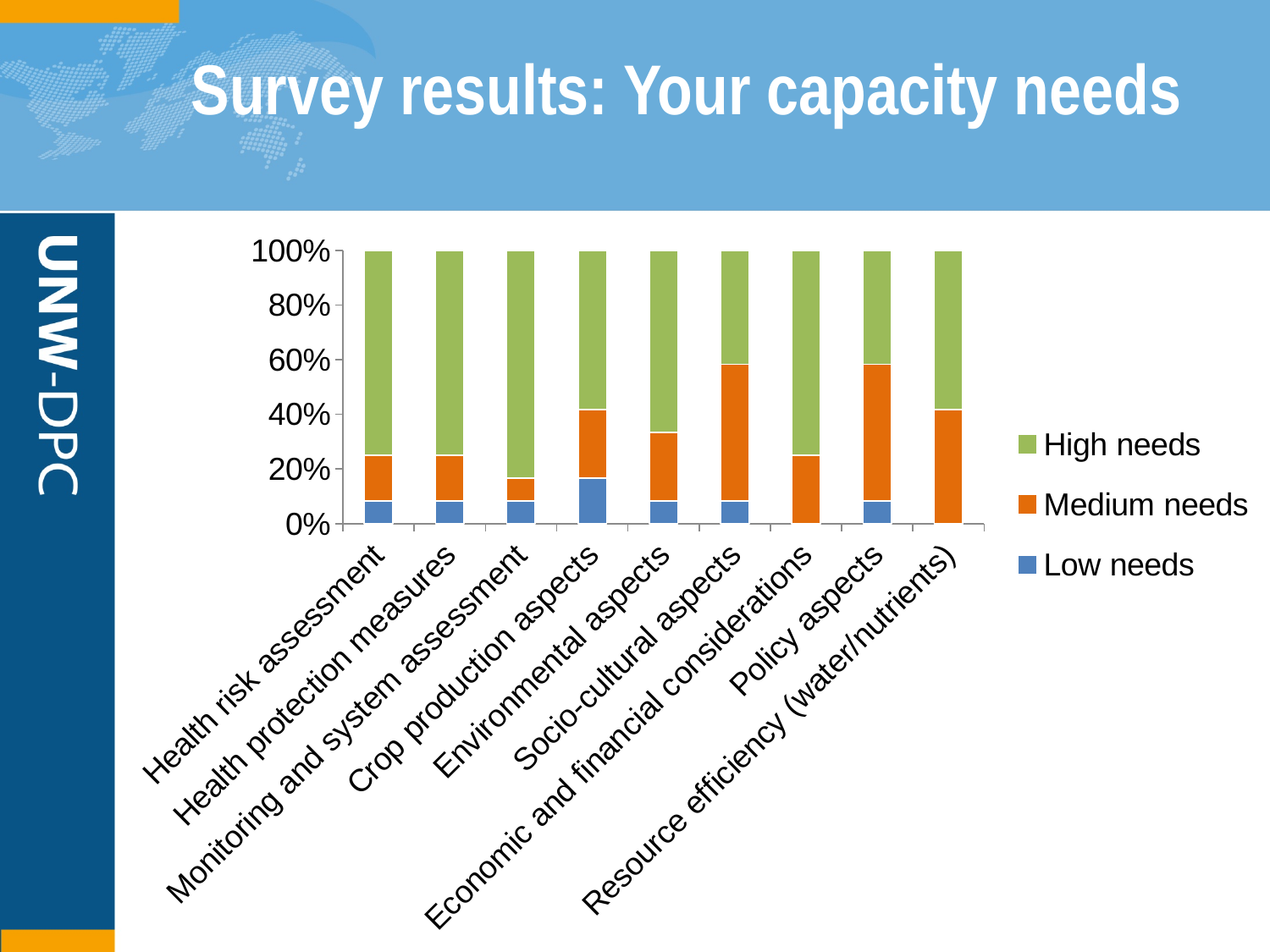
How many categories are shown along the x axis of the chart? 9 Is the 'High needs' share for Resource efficiency (water/nutrients) greater or less than 80%? less What is the title of the slide containing the chart? Survey results: Your capacity needs How many series does the chart's legend list? 3 Which colour represents 'High needs' in the chart? Green Which category has the largest 'High needs' segment? Monitoring and system assessment Is the 'High needs' share for Socio-cultural aspects greater or less than 60%? less What type of chart is shown on the slide? Stacked bar chart Which is larger, the 'Medium needs' segment for Socio-cultural aspects or for Health risk assessment? Socio-cultural aspects What is the total of the stacked bar for Policy aspects? 100% Is the 'Low needs' value for Health risk assessment greater or less than 20%? less Which is larger, the 'Low needs' segment for Crop production aspects or for Environmental aspects? Crop production aspects